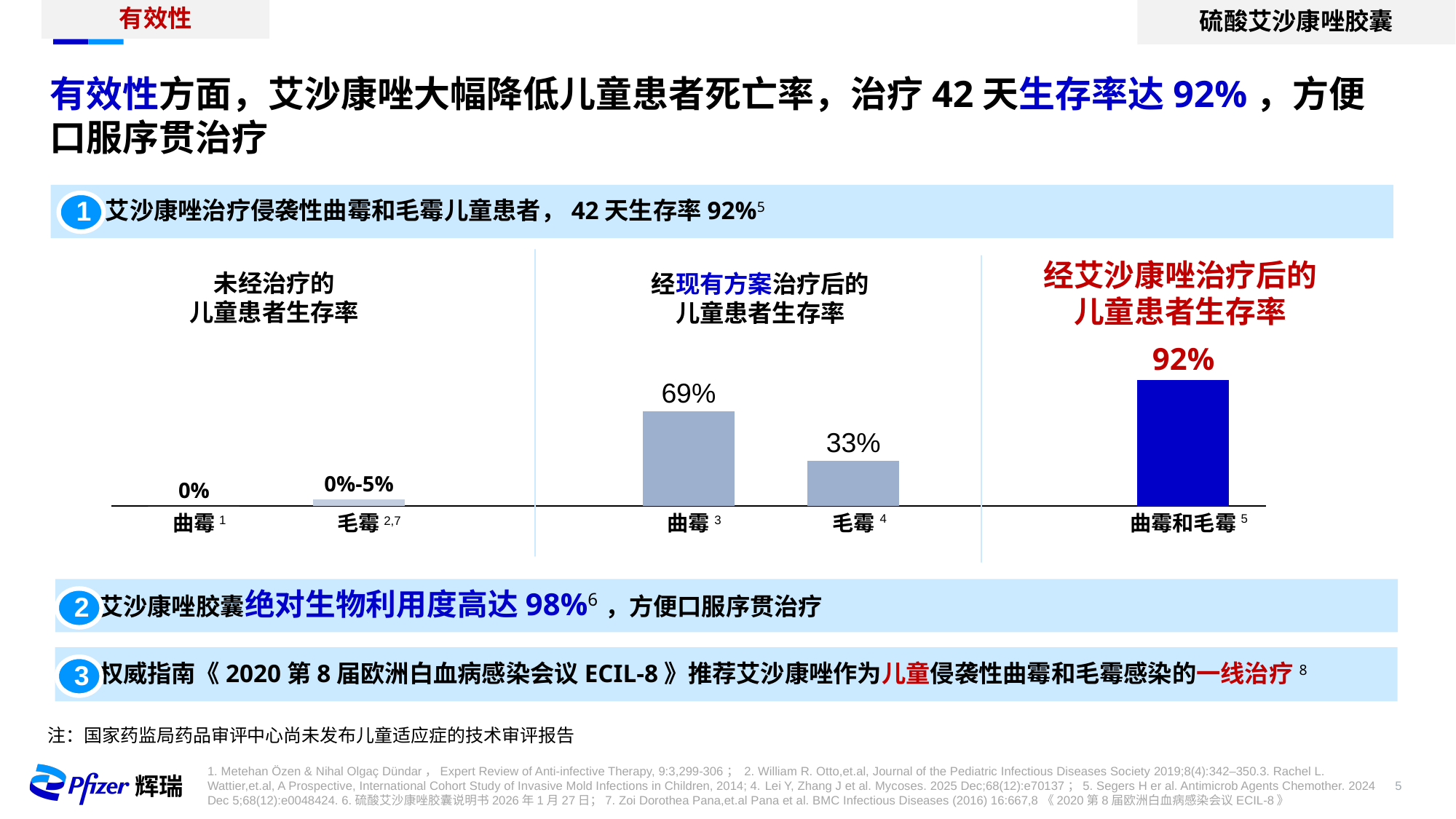
What is the survival rate shown for 曲霉 in the 经现有方案治疗后的儿童患者生存率 group? 69% What kind of chart is shown on the slide? bar chart What is the difference between the survival rates for 曲霉 (69%) and 毛霉 (33%) in the existing-treatment group? 36 percentage points Which bar in the chart has the highest survival rate? 曲霉和毛霉 (经艾沙康唑治疗后), 92% How many bars (categories) are plotted in the chart? 5 Which bar in the chart has the lowest survival rate? 曲霉 (未经治疗), 0% How many percentage points higher is the 92% survival rate after isavuconazole treatment than the 69% rate for 曲霉 under existing treatment? 23 percentage points What is the survival rate shown for 毛霉 in the 经现有方案治疗后的儿童患者生存率 group? 33% What value is shown for 曲霉 in the 未经治疗的儿童患者生存率 group? 0% Which is larger: the survival rate for 曲霉 or for 毛霉 in the 经现有方案治疗后 group? 曲霉 (69%) What value is shown for 毛霉 in the 未经治疗的儿童患者生存率 group? 0%-5% What is the survival rate shown for 曲霉和毛霉 in the 经艾沙康唑治疗后的儿童患者生存率 group? 92%